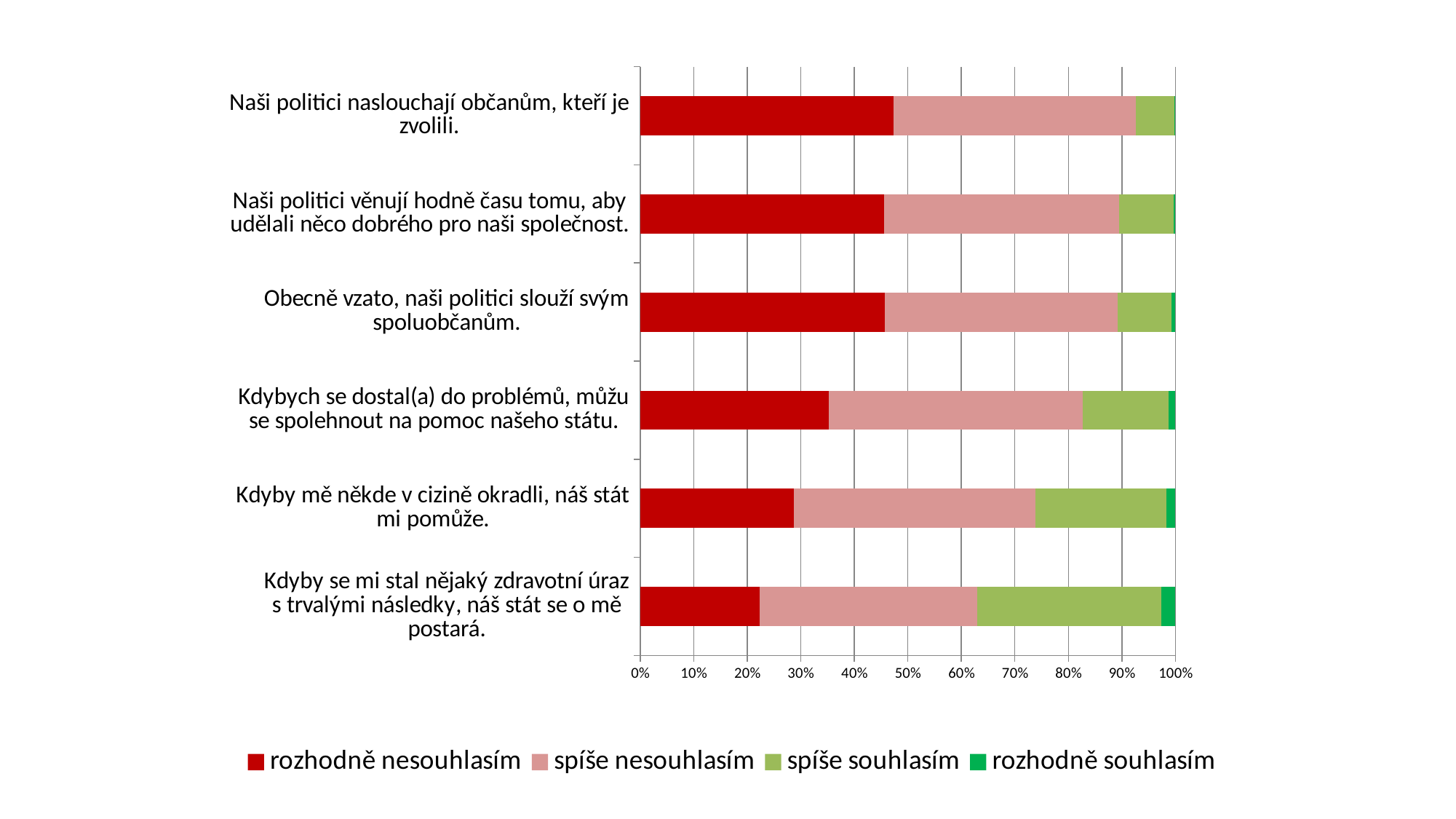
Is the 'rozhodně nesouhlasím' share for 'Naši politici naslouchají občanům, kteří je zvolili.' greater or less than 40%? greater Which statement has the smallest 'rozhodně nesouhlasím' segment? Kdyby se mi stal nějaký zdravotní úraz s trvalými následky, náš stát se o mě postará. What kind of chart is shown on the slide? Stacked bar chart How many statements (categories) are plotted on the chart? 6 Is the 'rozhodně nesouhlasím' share for 'Kdyby mě někde v cizině okradli, náš stát mi pomůže.' greater or less than 40%? less Is the 'rozhodně nesouhlasím' share for 'Kdyby se mi stal nějaký zdravotní úraz s trvalými následky, náš stát se o mě postará.' greater or less than 30%? less Which has the larger 'spíše souhlasím' share: 'Naši politici naslouchají občanům, kteří je zvolili.' or 'Kdyby se mi stal nějaký zdravotní úraz s trvalými následky, náš stát se o mě postará.'? Kdyby se mi stal nějaký zdravotní úraz s trvalými následky, náš stát se o mě postará. How many series does the legend list? 4 Which statement has the largest 'spíše souhlasím' segment? Kdyby se mi stal nějaký zdravotní úraz s trvalými následky, náš stát se o mě postará. What is the highest value shown on the horizontal axis? 100% Which has the larger 'rozhodně nesouhlasím' share: 'Kdybych se dostal(a) do problémů, můžu se spolehnout na pomoc našeho státu.' or 'Kdyby mě někde v cizině okradli, náš stát mi pomůže.'? Kdybych se dostal(a) do problémů, můžu se spolehnout na pomoc našeho státu. Which series is shown in bright green in the legend? rozhodně souhlasím